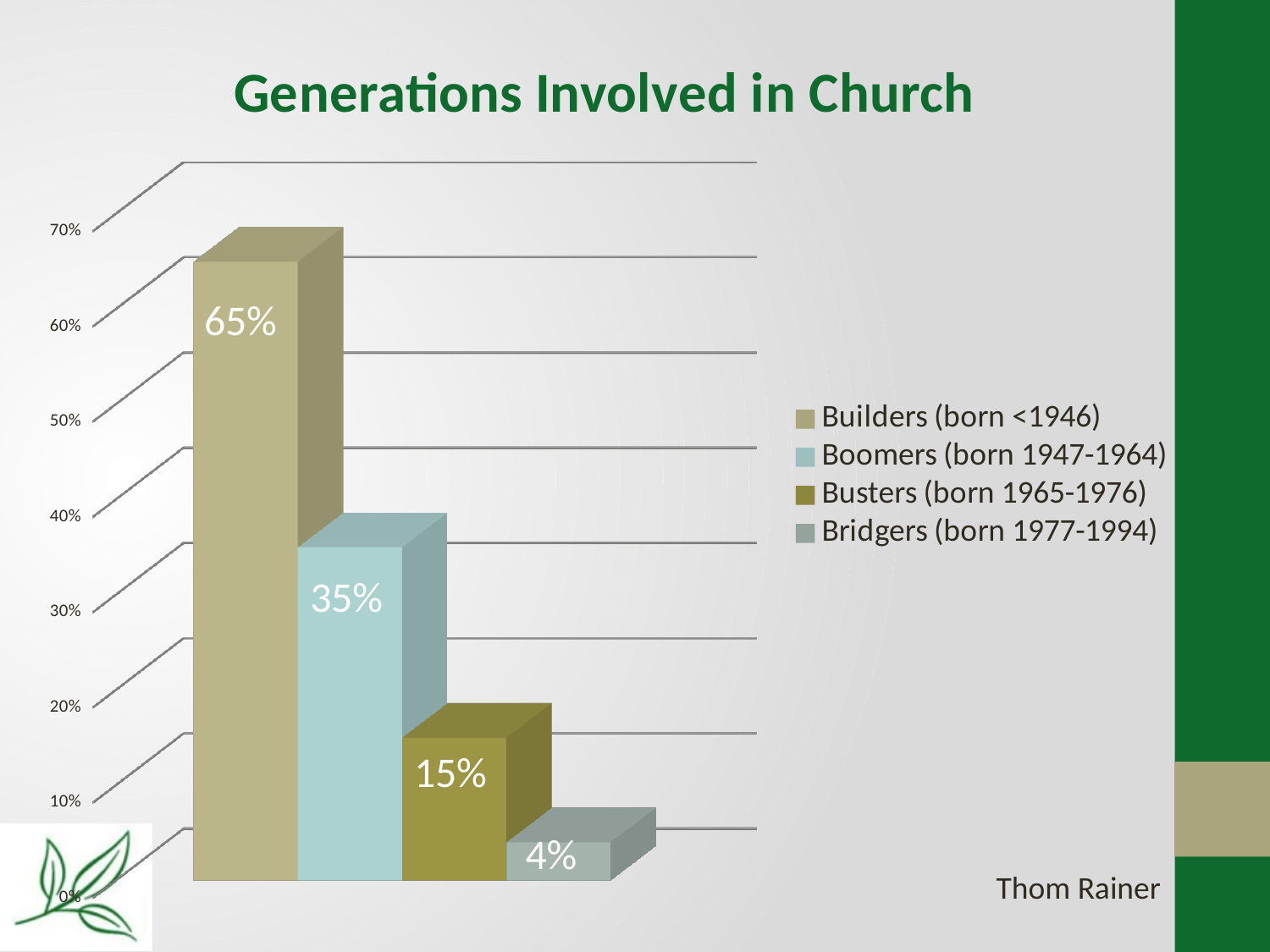
Which generation has the highest value? Builders (born <1946) Which generation has the lowest value? Bridgers (born 1977-1994) What is the value for Bridgers (born 1977-1994)? 4% What is the value for Boomers (born 1947-1964)? 35% What is the value for Builders (born <1946)? 65% Which is larger, the value for Boomers or the value for Busters? Boomers How many generations are plotted in the chart? 4 What is the difference between the values for Busters and Bridgers? 11% What is the value for Busters (born 1965-1976)? 15% What is the title of the chart? Generations Involved in Church What kind of chart is shown on the slide? Bar chart What is the difference between the values for Builders and Boomers? 30%